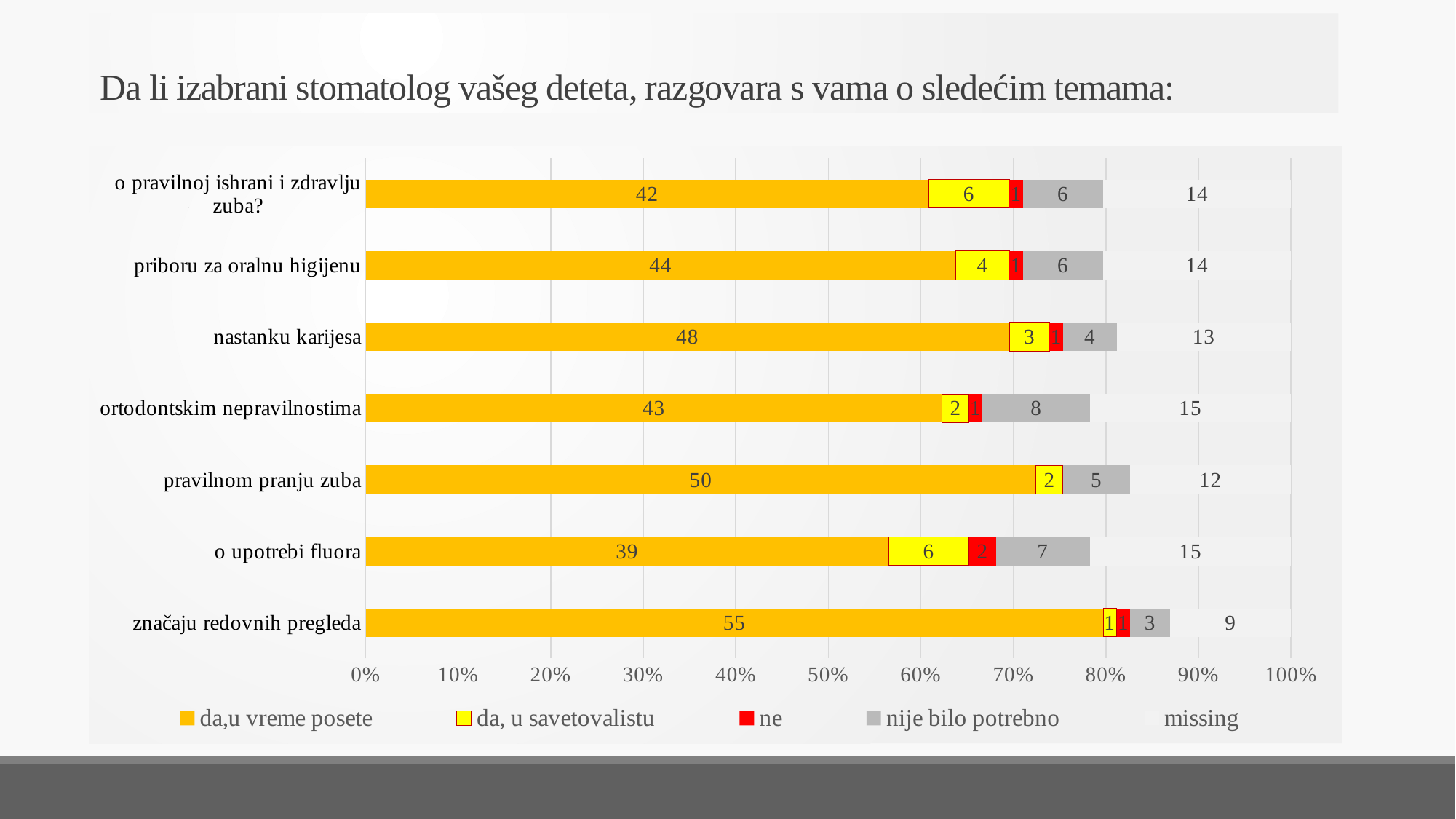
Which is larger: the "da, u savetovalistu" value for "o pravilnoj ishrani i zdravlju zuba?" or for "priboru za oralnu higijenu"? o pravilnoj ishrani i zdravlju zuba? What is the value of "da,u vreme posete" for "nastanku karijesa"? 48 Which topic has the lowest value for "da,u vreme posete"? o upotrebi fluora What is the total of all segments in the bar for "o upotrebi fluora"? 69 How many series does the legend list? 5 How many categories (topics) are listed on the chart? 7 What kind of chart is shown on the slide? stacked bar chart What is the difference between the "da,u vreme posete" values for "pravilnom pranju zuba" and "o upotrebi fluora"? 11 Which topic has the highest value for "da,u vreme posete"? značaju redovnih pregleda What is the "missing" value for "značaju redovnih pregleda"? 9 Which colour represents the "ne" series in the legend? red What is the value of "nije bilo potrebno" for "ortodontskim nepravilnostima"? 8